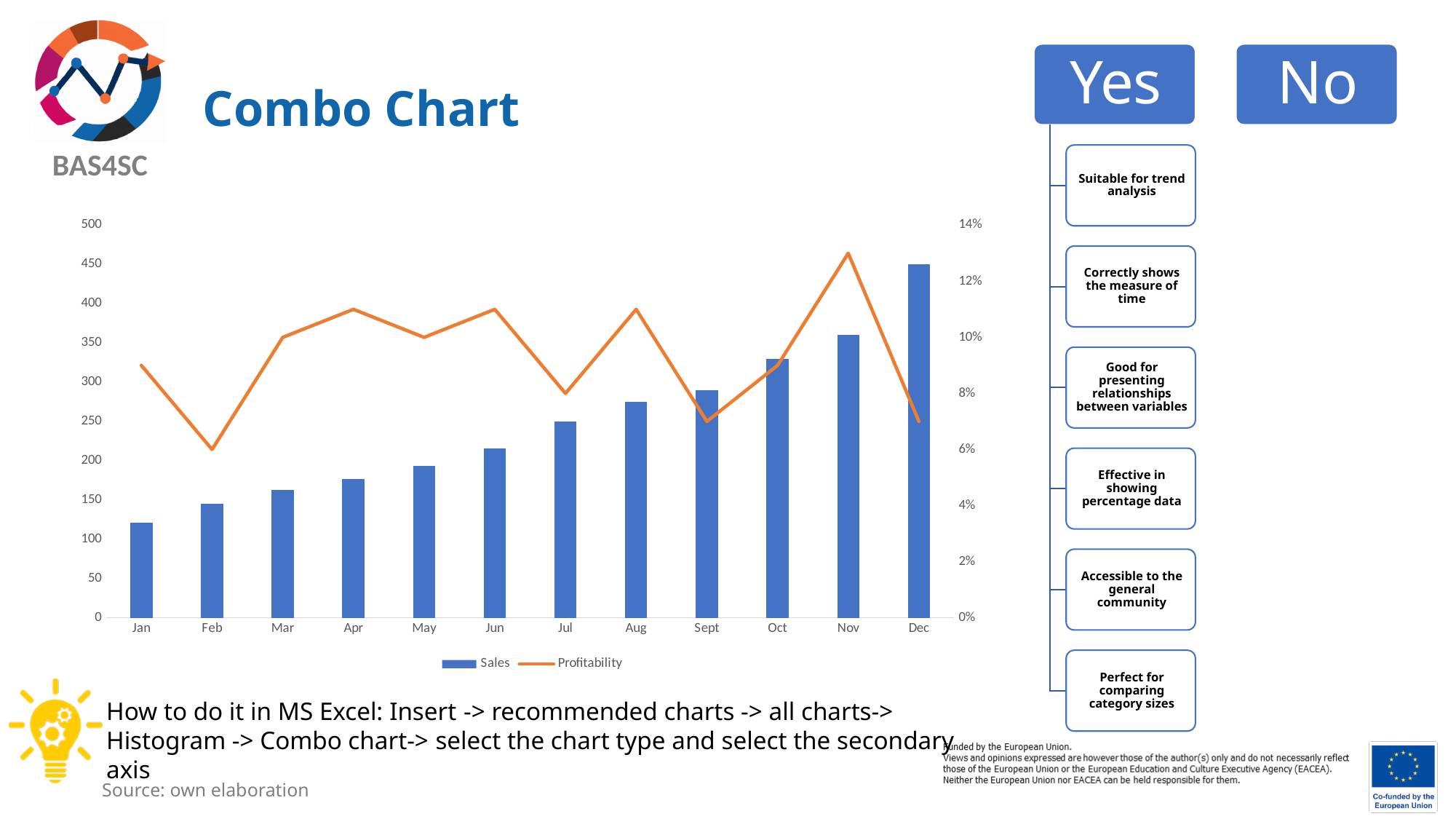
Is the Sales value for Jan greater or less than 150? less Which month has the highest Sales bar? Dec How many series does the chart legend list? 2 In which month does the Profitability line reach its lowest point? Feb What kind of chart is shown on the slide? A combo chart (bar chart with a line) In which month does the Profitability line reach its highest point? Nov Is the Profitability value for Nov greater or less than 12%? greater Is the Sales value for Dec greater or less than 400? greater Do the Sales bars generally rise or fall from Jan to Dec? rise Which month has the lowest Sales bar? Jan Which series is drawn as an orange line in the chart? Profitability How many months are shown on the x axis of the chart? 12